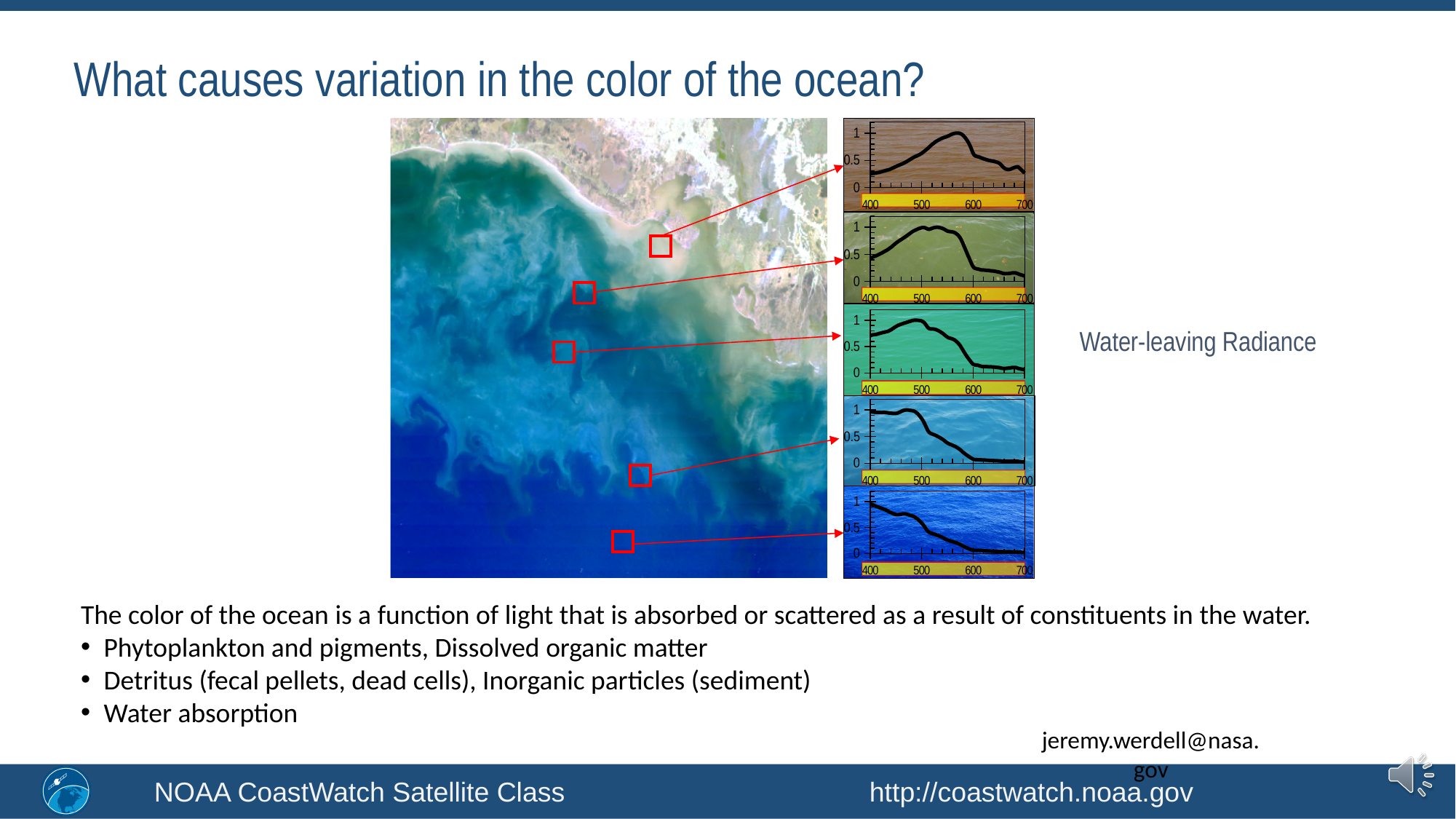
In the bottom (dark blue) chart, does the value rise or fall as the wavelength increases from 400 to 700? fall How many small charts are shown on the right side of the slide? 5 In the top (brown) chart, is the value at 400 greater or less than 0.5? less In the second chart from the top (olive green), is the value at 500 greater or less than 0.5? greater In the fourth chart from the top (light blue), is the value at 700 greater or less than 0.5? less In the fourth chart from the top (light blue), does the value rise or fall as the wavelength increases from 400 to 700? fall What kind of chart are the five small charts on the right of the slide? line chart What is the highest tick label on the x axis of the small charts? 700 What label appears to the right of the stack of small charts? Water-leaving Radiance